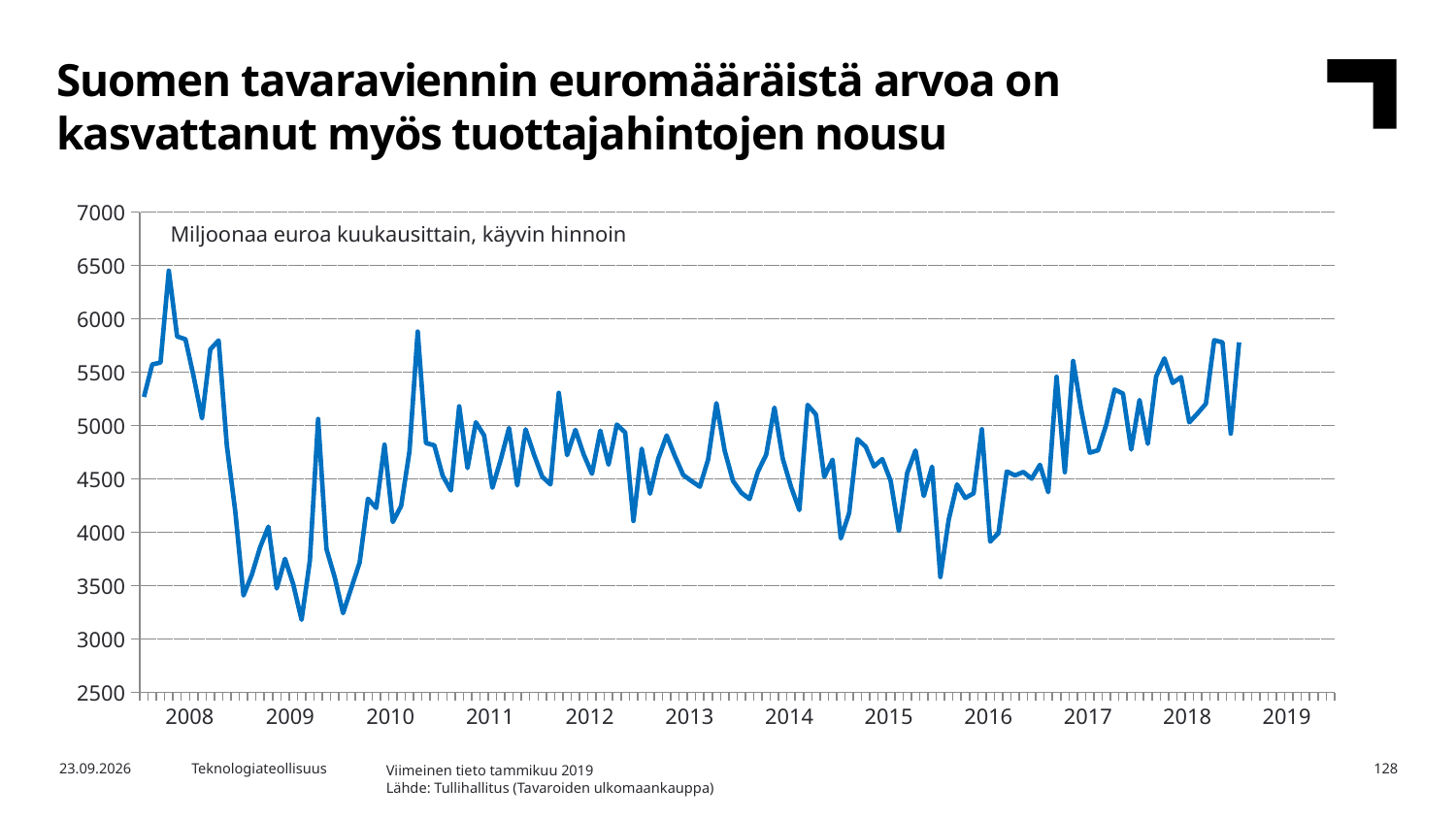
What is the highest value shown on the vertical axis? 7000 In which year does the line reach its lowest point? 2009 What kind of chart is shown on the slide? line chart Is the peak value in 2010 greater or less than 5500? greater In which year does the line reach its highest point? 2008 Do the values generally rise or fall from 2016 to 2018? rise Is the lowest value in 2009 greater or less than 3500? less Is the last plotted value, at the start of 2019, greater or less than 5500? greater What is the subtitle printed inside the chart area? Miljoonaa euroa kuukausittain, käyvin hinnoin Do the values generally rise or fall from late 2008 to early 2009? fall